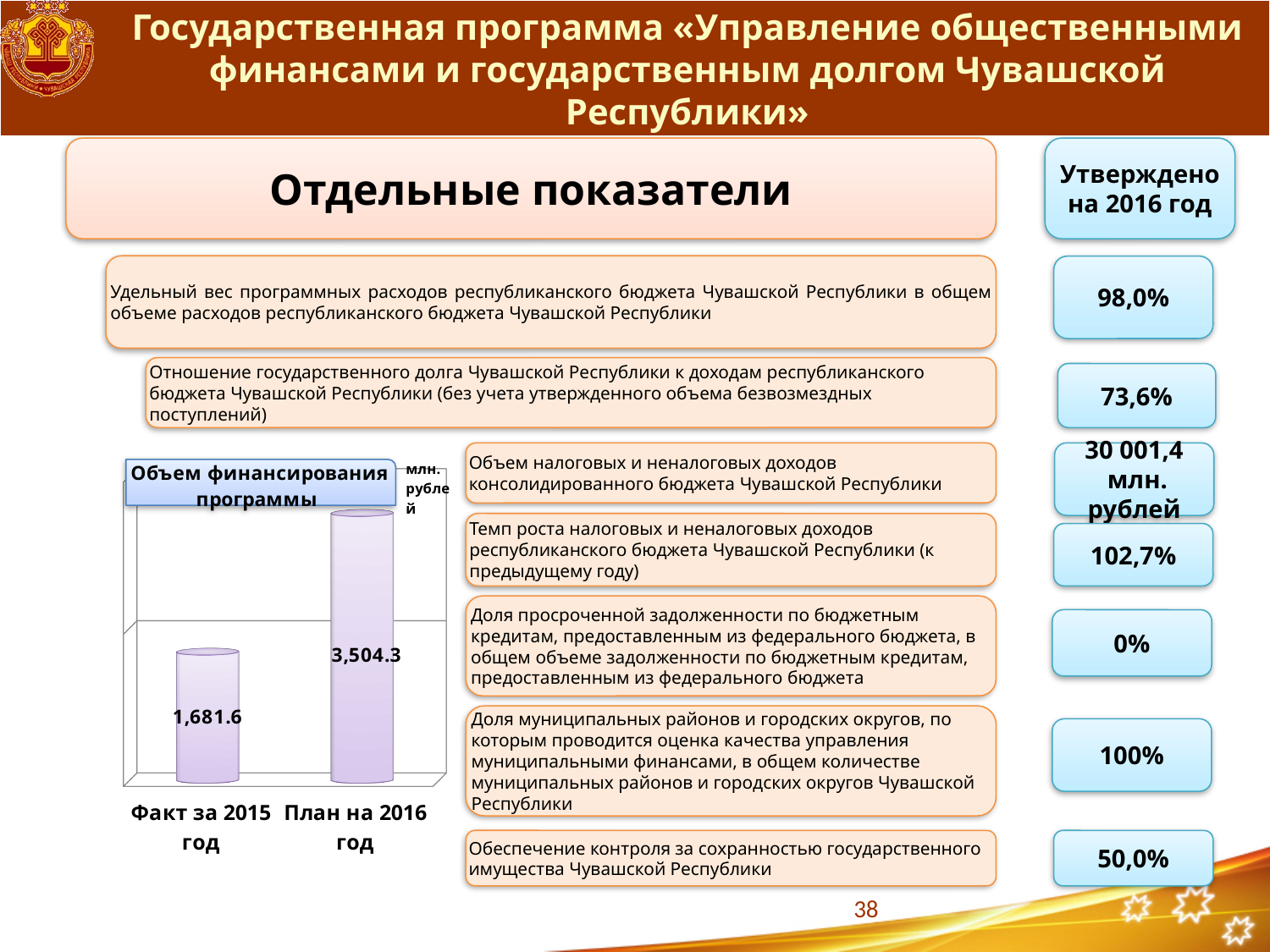
What is the value for "План на 2016 год" in the chart "Объем финансирования программы"? 3,504.3 How many categories are shown in the chart "Объем финансирования программы"? 2 What is the title of the chart on the slide? Объем финансирования программы What is the value for "Факт за 2015 год" in the chart "Объем финансирования программы"? 1,681.6 In what units are the values of the chart "Объем финансирования программы" given? млн. рублей What kind of chart is "Объем финансирования программы"? Bar chart What is the difference between the values for "План на 2016 год" and "Факт за 2015 год" in the chart? 1,822.7 Do the values in the chart rise or fall from "Факт за 2015 год" to "План на 2016 год"? Rise Which is larger in the chart: the value for "Факт за 2015 год" or for "План на 2016 год"? План на 2016 год Which category has the highest value in the chart "Объем финансирования программы"? План на 2016 год Which category has the lowest value in the chart "Объем финансирования программы"? Факт за 2015 год